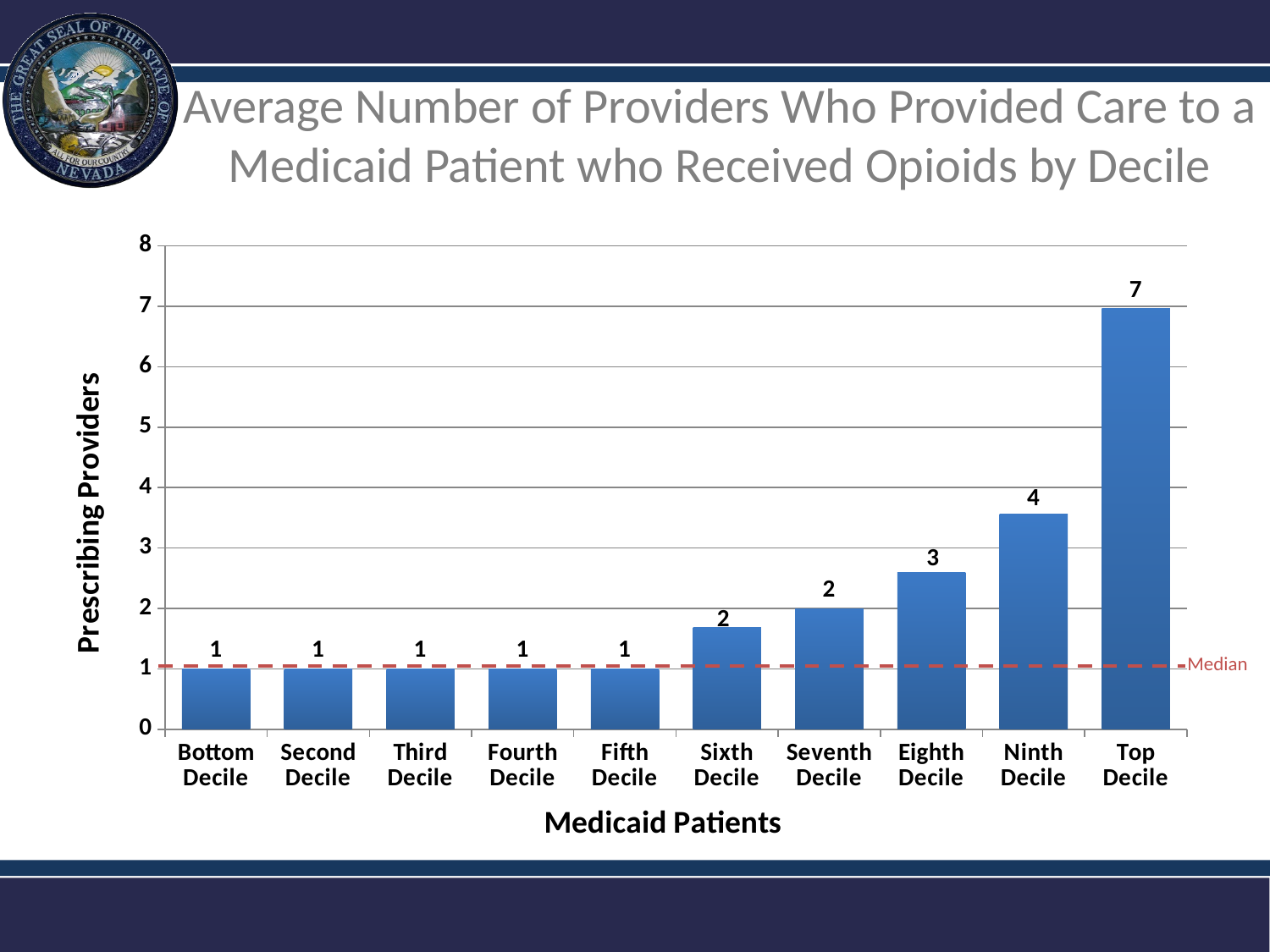
Which is larger, the value for the Top Decile or the Ninth Decile? Top Decile What type of chart is shown on the slide? bar chart Which decile has the highest number of prescribing providers? Top Decile What does the red dashed horizontal line represent? Median What is the data label for the Top Decile? 7 What is the data label for the Ninth Decile? 4 How many deciles are shown on the x axis? 10 What is the data label for the Bottom Decile? 1 Is the value for the Ninth Decile greater or less than 3? greater Do the values rise or fall moving from the Bottom Decile to the Top Decile? rise What is the data label for the Eighth Decile? 3